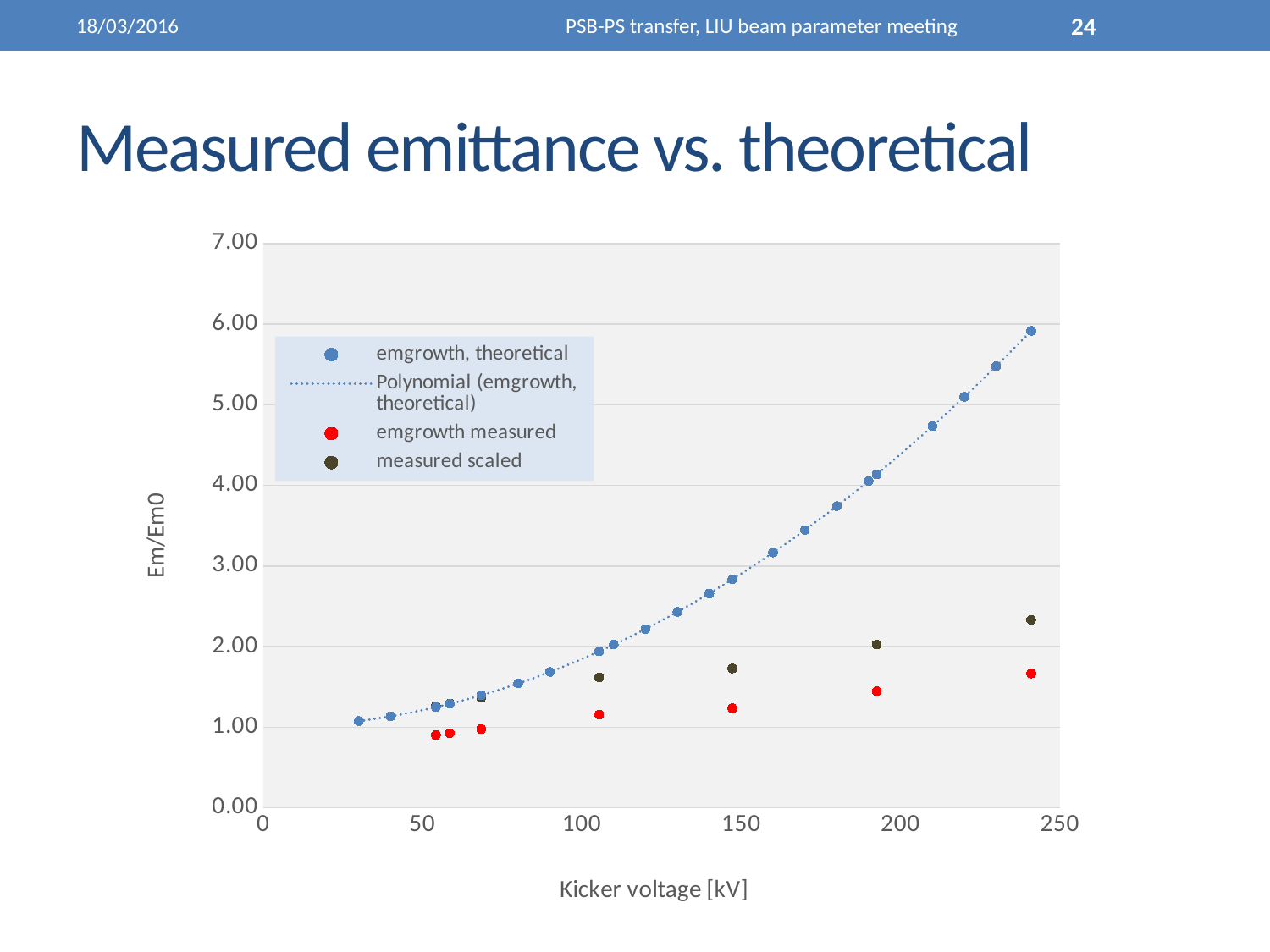
How many series does the chart legend list? 4 Is the 'emgrowth, theoretical' value at the highest kicker voltage (about 240 kV) greater or less than 5.00? greater Is the 'measured scaled' value at the highest kicker voltage (about 240 kV) greater or less than 2.00? greater What is the label of the y axis? Em/Em0 What is the label of the x axis? Kicker voltage [kV] At the highest kicker voltage (about 240 kV), which series has the larger value: 'emgrowth, theoretical' or 'emgrowth measured'? emgrowth, theoretical Is the 'emgrowth measured' value at the highest kicker voltage (about 240 kV) greater or less than 2.00? less Do the 'emgrowth, theoretical' values rise or fall as kicker voltage increases? Rise What kind of chart is shown on the slide? Scatter chart How many 'emgrowth measured' (red) points are plotted? 7 At about 150 kV, which series has the larger value: 'measured scaled' or 'emgrowth measured'? measured scaled